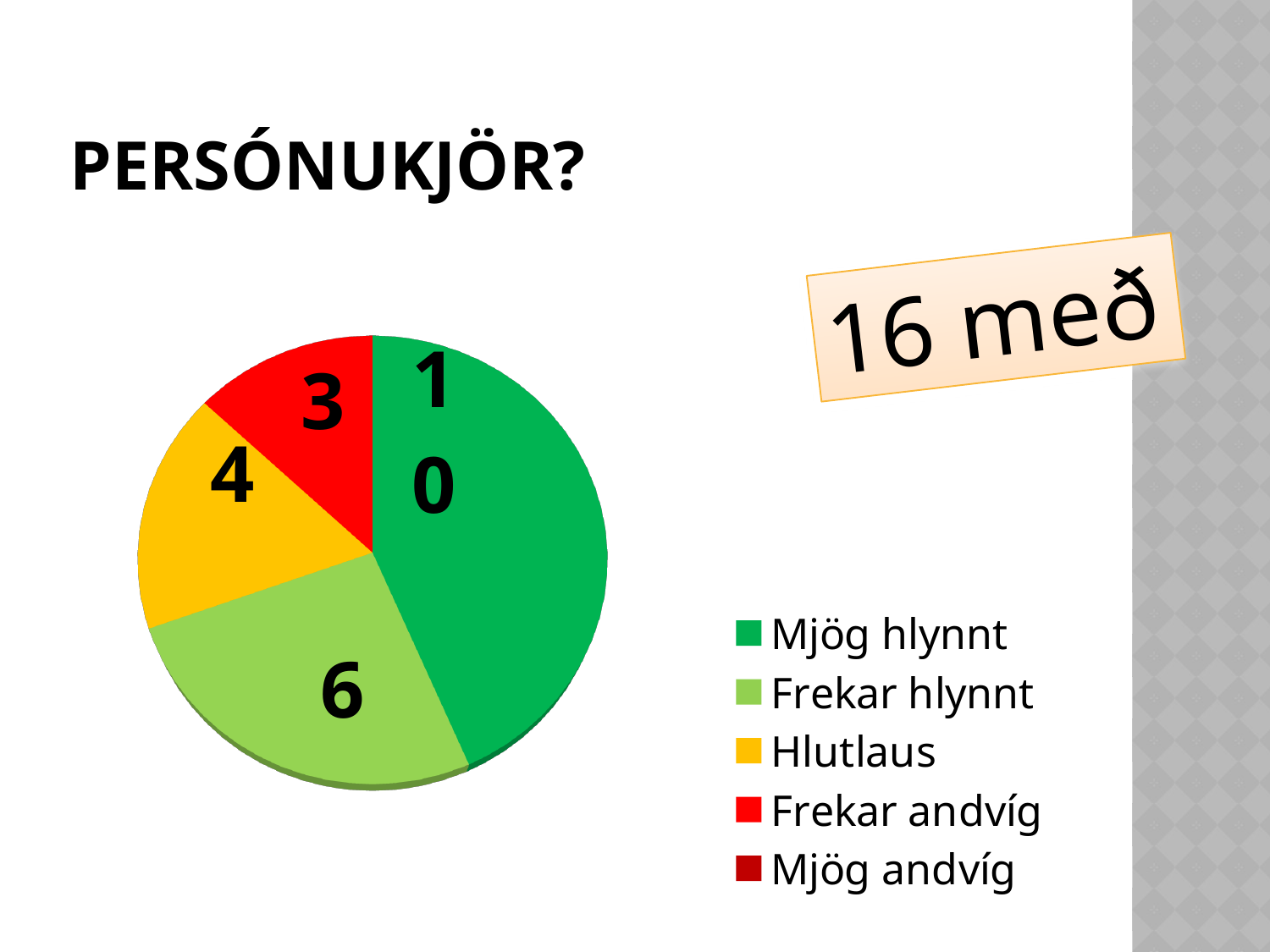
What is the difference between the values for Mjög hlynnt and Frekar hlynnt? 4 What colour is the Hlutlaus slice in the pie chart? yellow What kind of chart is shown on the slide? pie chart What is the value for Mjög hlynnt in the pie chart? 10 Which of the visible slices in the pie chart is the smallest? Frekar andvíg What is the value for Hlutlaus in the pie chart? 4 What is the title of the slide containing the pie chart? PERSÓNUKJÖR? Which is larger, the value for Hlutlaus or the value for Frekar andvíg? Hlutlaus What is the value for Frekar andvíg in the pie chart? 3 How many entries does the legend of the pie chart list? 5 Which category has the largest slice in the pie chart? Mjög hlynnt What is the value for Frekar hlynnt in the pie chart? 6